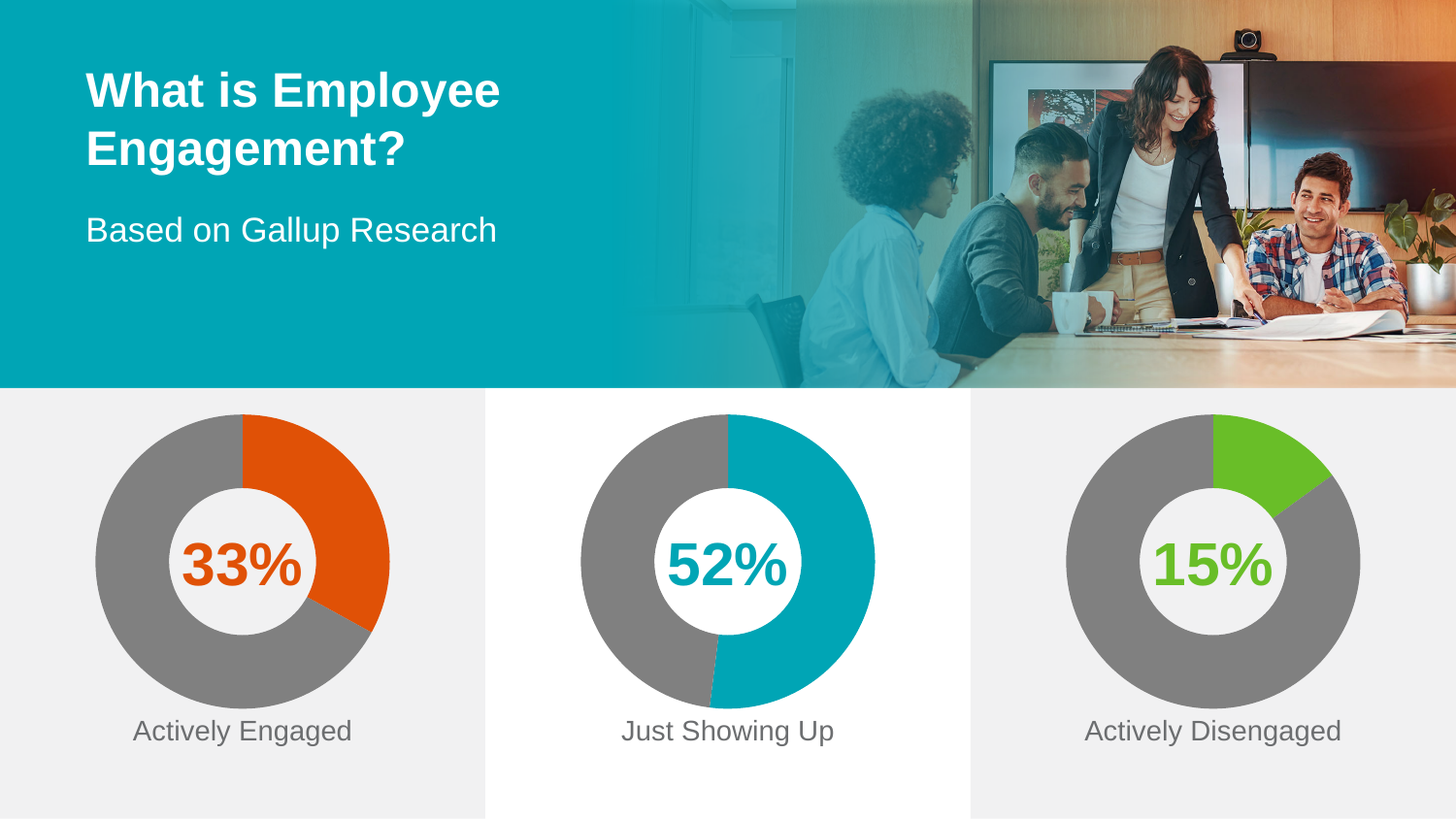
What colour is the highlighted segment in the 'Actively Disengaged' chart? Green What kind of chart is used for the 'Just Showing Up' figure? Donut chart Which is larger, the 'Actively Engaged' percentage or the 'Actively Disengaged' percentage? Actively Engaged What is the difference between the 'Just Showing Up' percentage and the 'Actively Engaged' percentage? 19% In the 'Actively Disengaged' chart, what percentage is shown? 15% In the 'Actively Engaged' chart, what percentage is shown? 33% What colour is the highlighted segment in the 'Actively Engaged' chart? Orange Across the three charts on the slide, which category has the lowest percentage? Actively Disengaged In the 'Just Showing Up' chart, what percentage is shown? 52% How many donut charts are shown on the slide? 3 Across the three charts on the slide, which category has the highest percentage? Just Showing Up What is the difference between the 'Actively Engaged' percentage and the 'Actively Disengaged' percentage? 18%